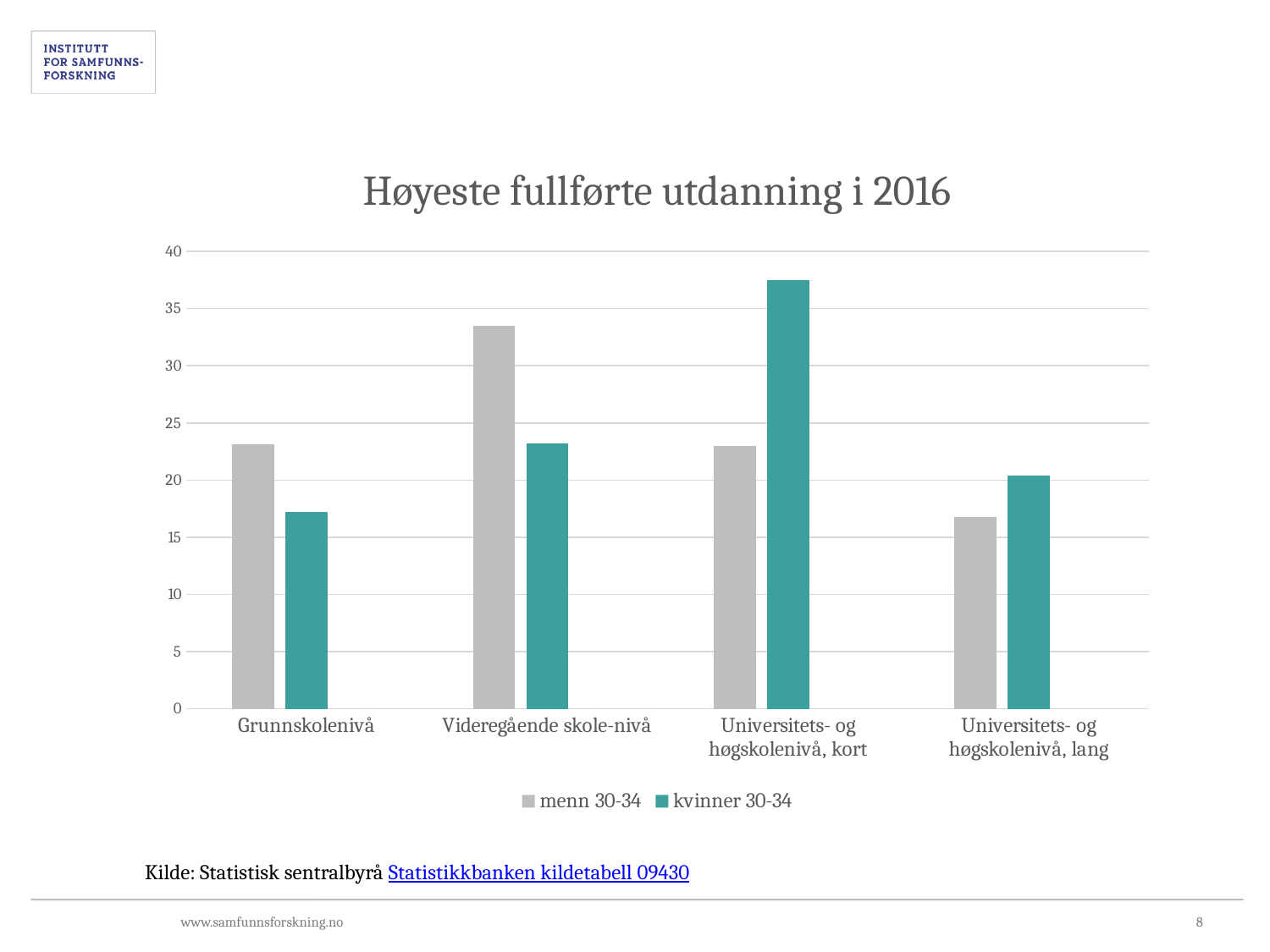
Is the value for kvinner 30-34 at Universitets- og høgskolenivå, kort greater or less than 35? greater What kind of chart is shown on the slide? bar chart For Grunnskolenivå, which series has the larger value, menn 30-34 or kvinner 30-34? menn 30-34 For Universitets- og høgskolenivå, kort, which series has the larger value, menn 30-34 or kvinner 30-34? kvinner 30-34 Is the value for menn 30-34 at Universitets- og høgskolenivå, lang greater or less than 20? less For which category is the value for menn 30-34 lowest? Universitets- og høgskolenivå, lang For which category is the value for menn 30-34 highest? Videregående skole-nivå How many series does the legend list? 2 For which category is the value for kvinner 30-34 lowest? Grunnskolenivå What is the title of the chart? Høyeste fullførte utdanning i 2016 For which category is the value for kvinner 30-34 highest? Universitets- og høgskolenivå, kort How many education-level categories are shown on the x axis? 4